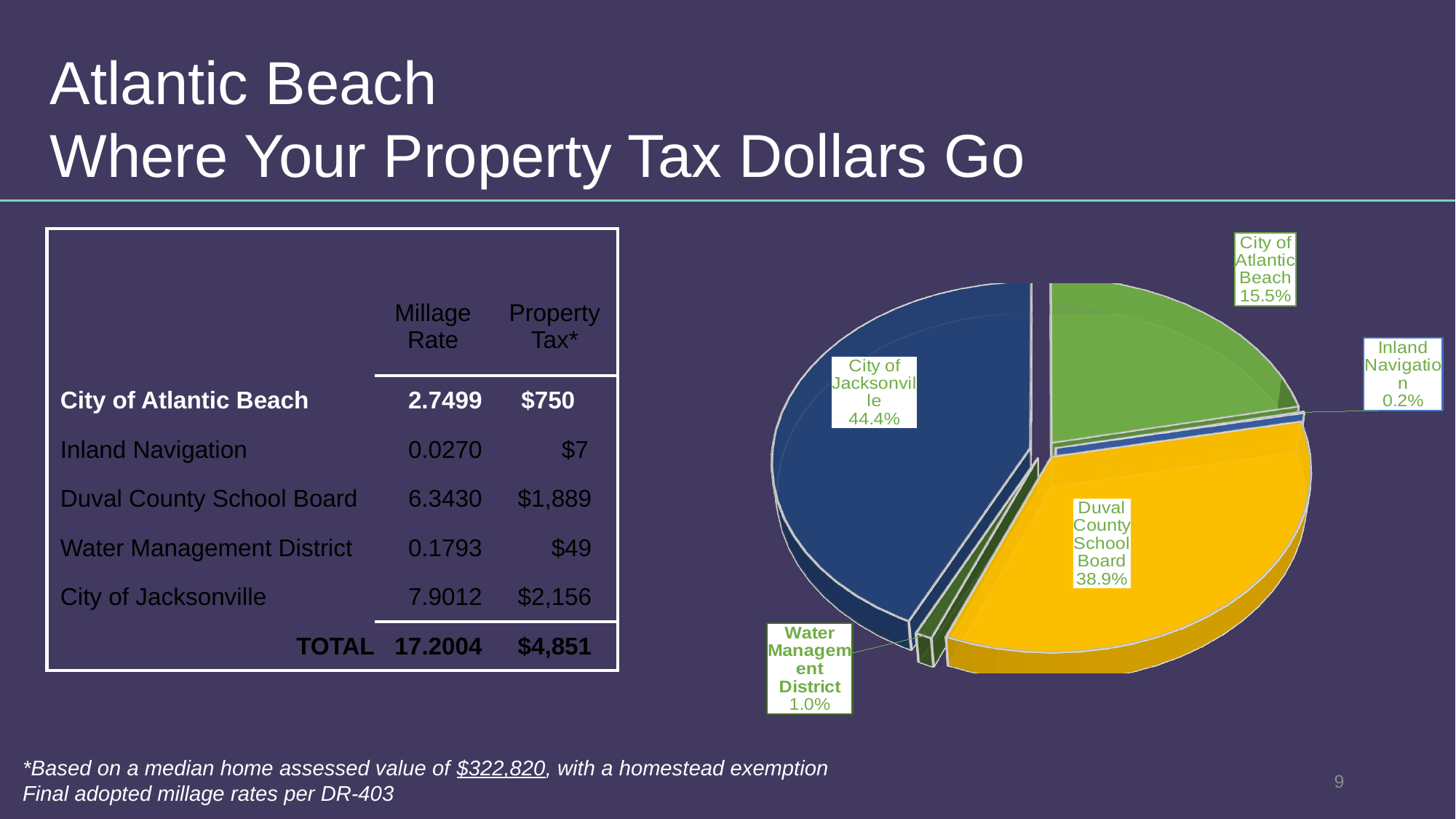
What colour is the Duval County School Board slice in the pie chart? yellow What kind of chart is shown on the slide? pie chart What share of the pie does Water Management District represent? 1.0% What share of the pie does Inland Navigation represent? 0.2% Which is larger in the pie chart, City of Atlantic Beach or Duval County School Board? Duval County School Board Which slice of the pie chart is the largest? City of Jacksonville What share of the pie does City of Atlantic Beach represent? 15.5% How many slices does the pie chart have? 5 Which slice of the pie chart is the smallest? Inland Navigation By how many percentage points does the City of Jacksonville share exceed the Duval County School Board share? 5.5